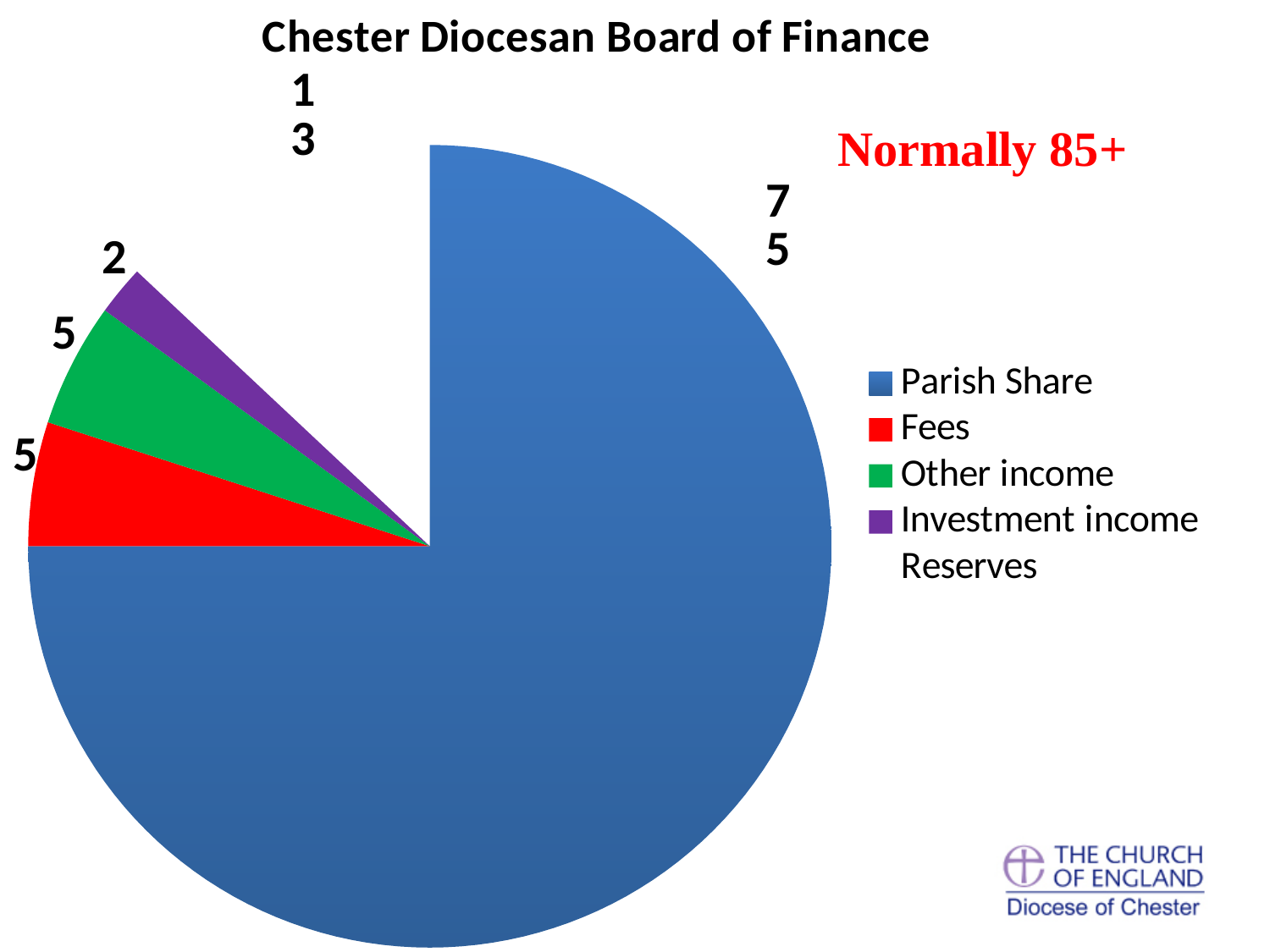
What is the title of the pie chart? Chester Diocesan Board of Finance What is the value shown for Fees in the pie chart? 5 What kind of chart is shown on the slide? Pie chart What is the difference between the Parish Share value and the Investment income value in the pie chart? 73 What colour is the Fees slice in the pie chart? Red Which is larger in the pie chart, Fees or Investment income? Fees Which category has the largest slice in the pie chart? Parish Share What is the value shown for Other income in the pie chart? 5 Which category has the smallest value in the pie chart? Investment income What is the value shown for Parish Share in the pie chart? 75 How many entries does the legend of the pie chart list? 5 What is the value shown for Investment income in the pie chart? 2